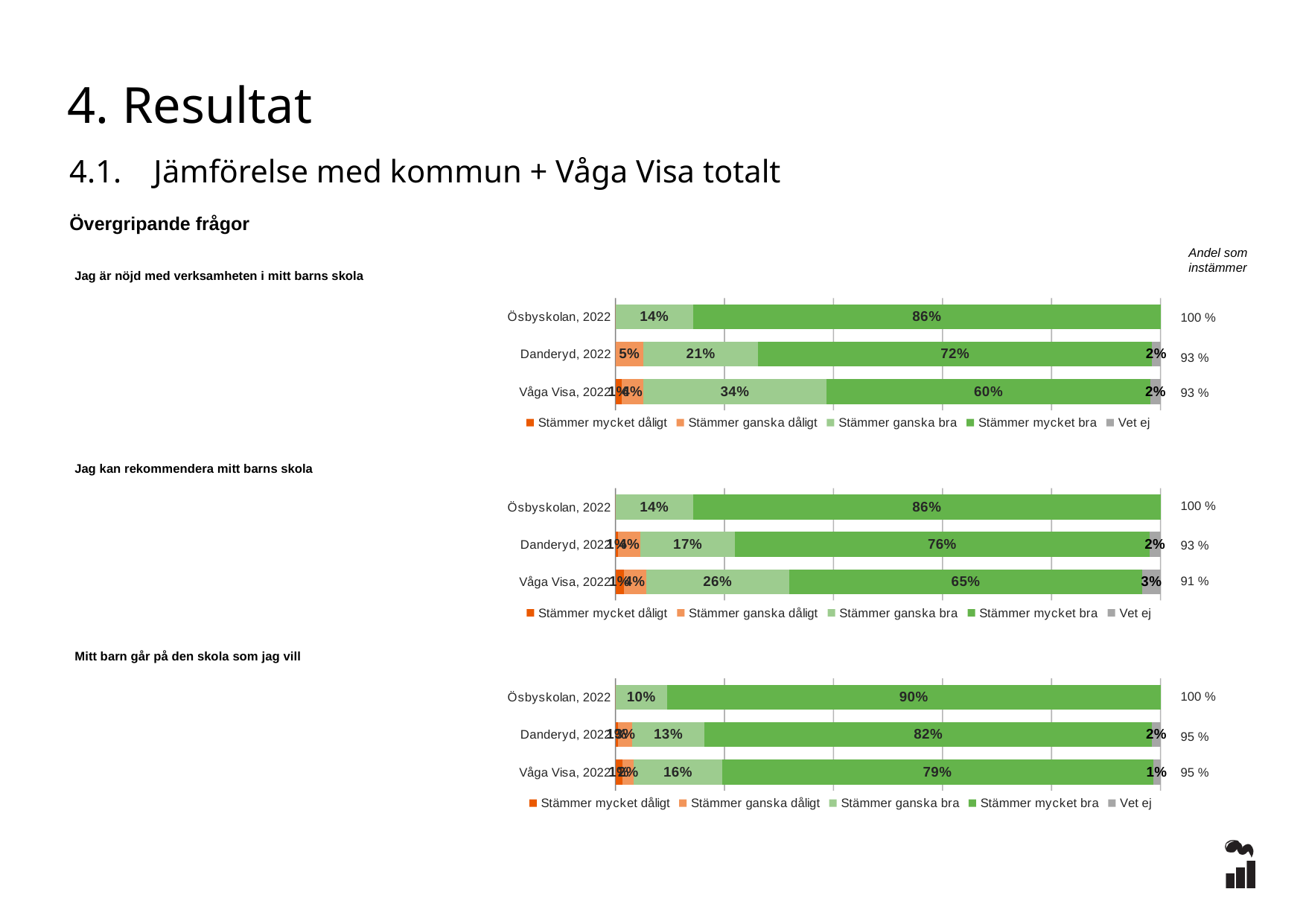
In the chart 'Mitt barn går på den skola som jag vill', what is the 'Stämmer mycket bra' value for Ösbyskolan, 2022? 90% In the chart 'Jag kan rekommendera mitt barns skola', which category has the lowest 'Stämmer mycket bra' value? Våga Visa, 2022 How many series does the legend list in the chart 'Jag är nöjd med verksamheten i mitt barns skola'? 5 In the chart 'Jag är nöjd med verksamheten i mitt barns skola', what is the 'Stämmer mycket bra' value for Ösbyskolan, 2022? 86% In the chart 'Jag kan rekommendera mitt barns skola', what is the 'Stämmer mycket bra' value for Danderyd, 2022? 76% In the chart 'Jag är nöjd med verksamheten i mitt barns skola', what is the difference between the 'Stämmer mycket bra' values for Danderyd, 2022 and Våga Visa, 2022? 12% In the chart 'Jag är nöjd med verksamheten i mitt barns skola', which category has the highest 'Stämmer mycket bra' value? Ösbyskolan, 2022 In the chart 'Mitt barn går på den skola som jag vill', what is the 'Stämmer ganska bra' value for Våga Visa, 2022? 16% In the chart 'Jag är nöjd med verksamheten i mitt barns skola', what is the 'Stämmer ganska bra' value for Våga Visa, 2022? 34% In the chart 'Jag kan rekommendera mitt barns skola', what is the 'Andel som instämmer' value shown for Våga Visa, 2022? 91 % In the chart 'Mitt barn går på den skola som jag vill', is the 'Stämmer mycket bra' value for Danderyd, 2022 larger or smaller than that for Våga Visa, 2022? larger What kind of chart is 'Jag kan rekommendera mitt barns skola'? Stacked bar chart